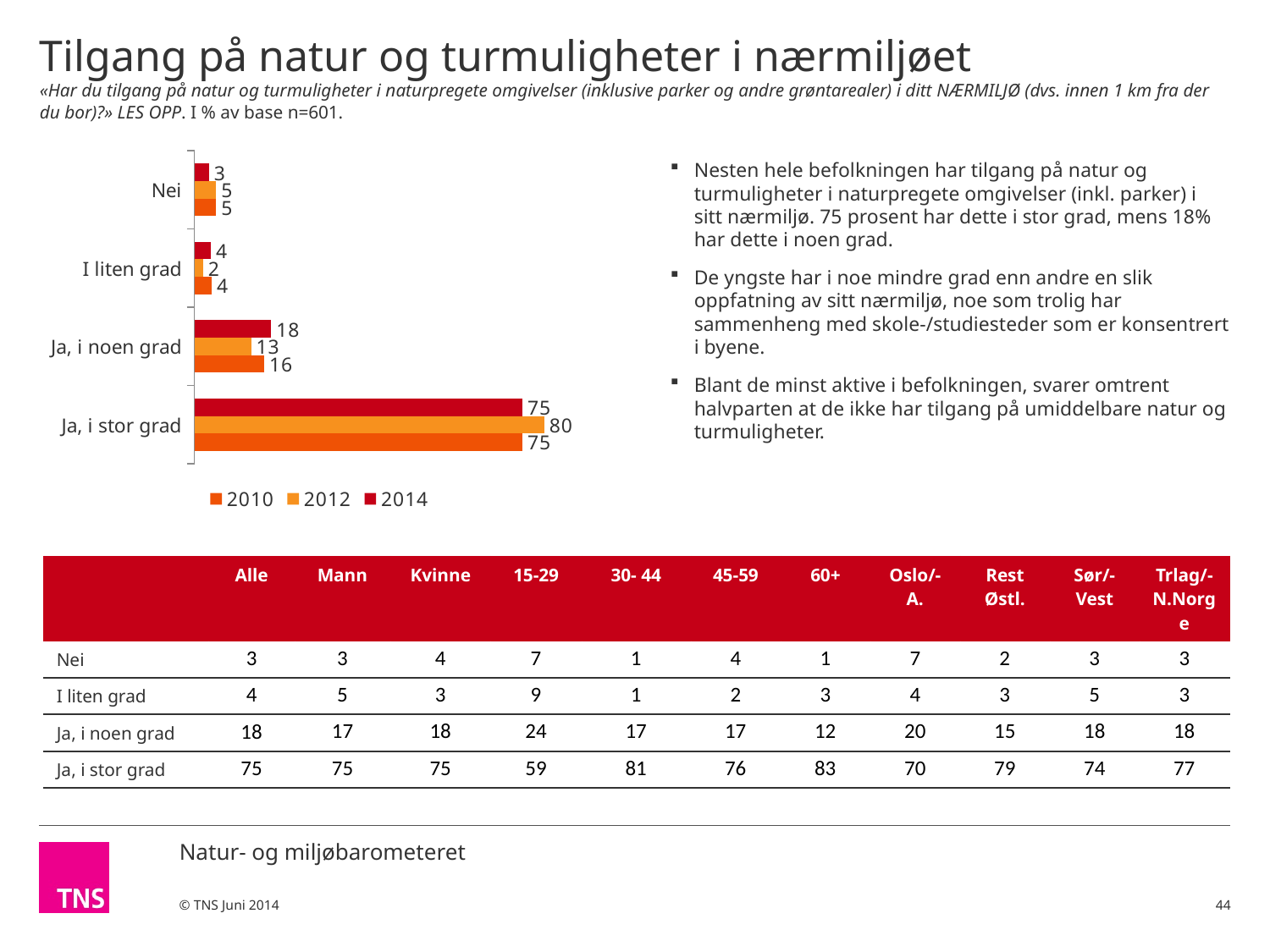
How many categories are shown on the chart? 4 Which category has the highest value for 2014? Ja, i stor grad What is the 2012 value for 'I liten grad'? 2 What is the 2012 value for 'Ja, i stor grad'? 80 What is the difference between the 2012 and 2014 values for 'Ja, i noen grad'? 5 What kind of chart is shown on the slide? bar chart How many series does the chart legend list? 3 Which series is shown in the darkest red colour in the legend? 2014 What is the 2014 value for 'Ja, i noen grad'? 18 Which is larger for 'Ja, i stor grad': the 2012 value or the 2014 value? 2012 What is the 2014 value for 'Ja, i stor grad'? 75 What is the 2010 value for 'Nei'? 5